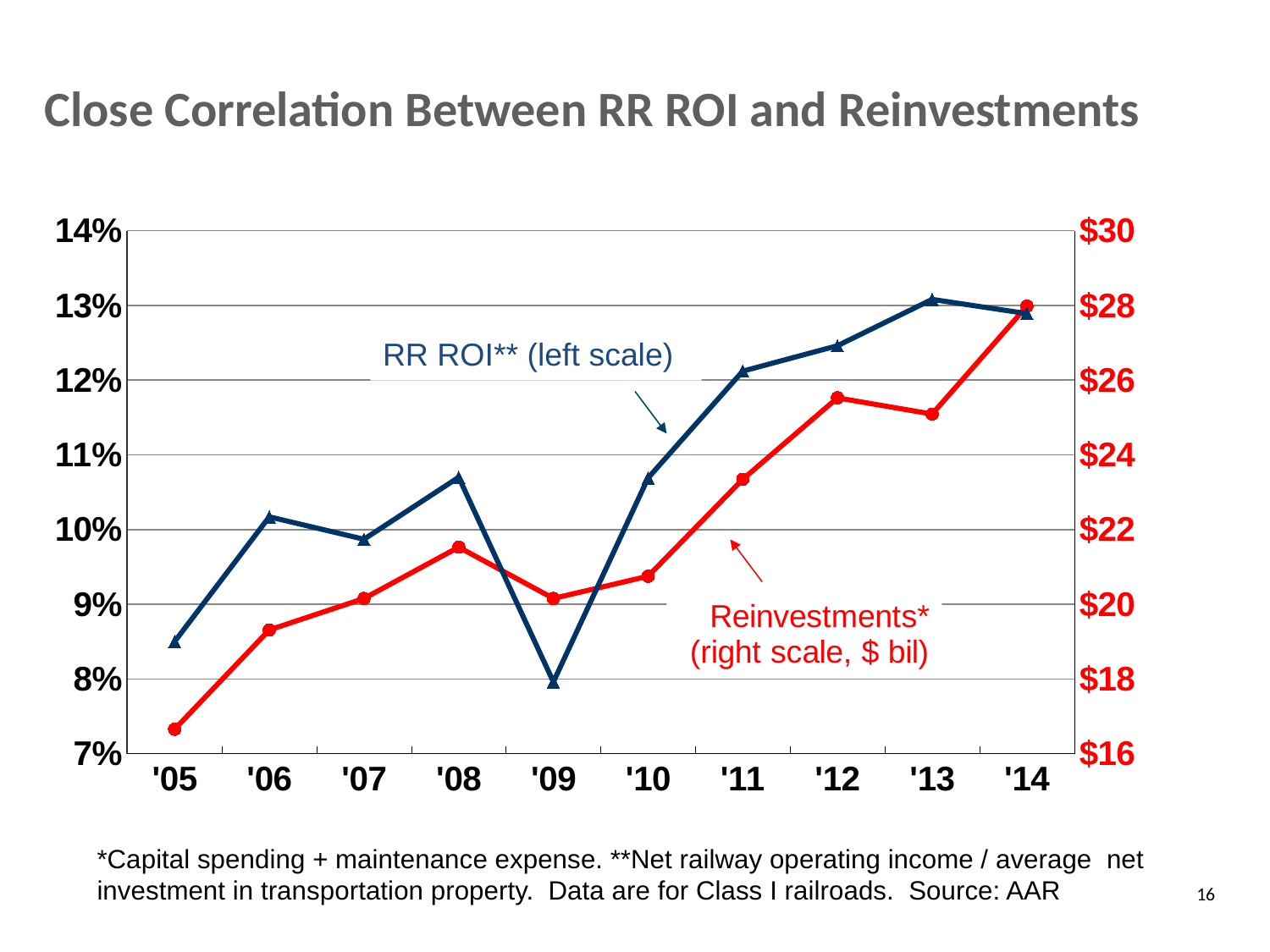
Which scale does the Reinvestments series use, and in what units? right scale, $ bil How many data series are plotted on the chart? 2 In which year is RR ROI at its lowest? '09 Is the RR ROI value for '12 greater or less than 12%? greater How many years are plotted along the x axis? 10 In which year are Reinvestments at their lowest? '05 Is the Reinvestments value for '11 greater or less than $22? greater In which year is RR ROI at its highest? '13 Is the Reinvestments value for '05 greater or less than $18? less What kind of chart is shown on the slide? line chart Do Reinvestments rise or fall from '05 to '08? rise In which year are Reinvestments at their highest? '14